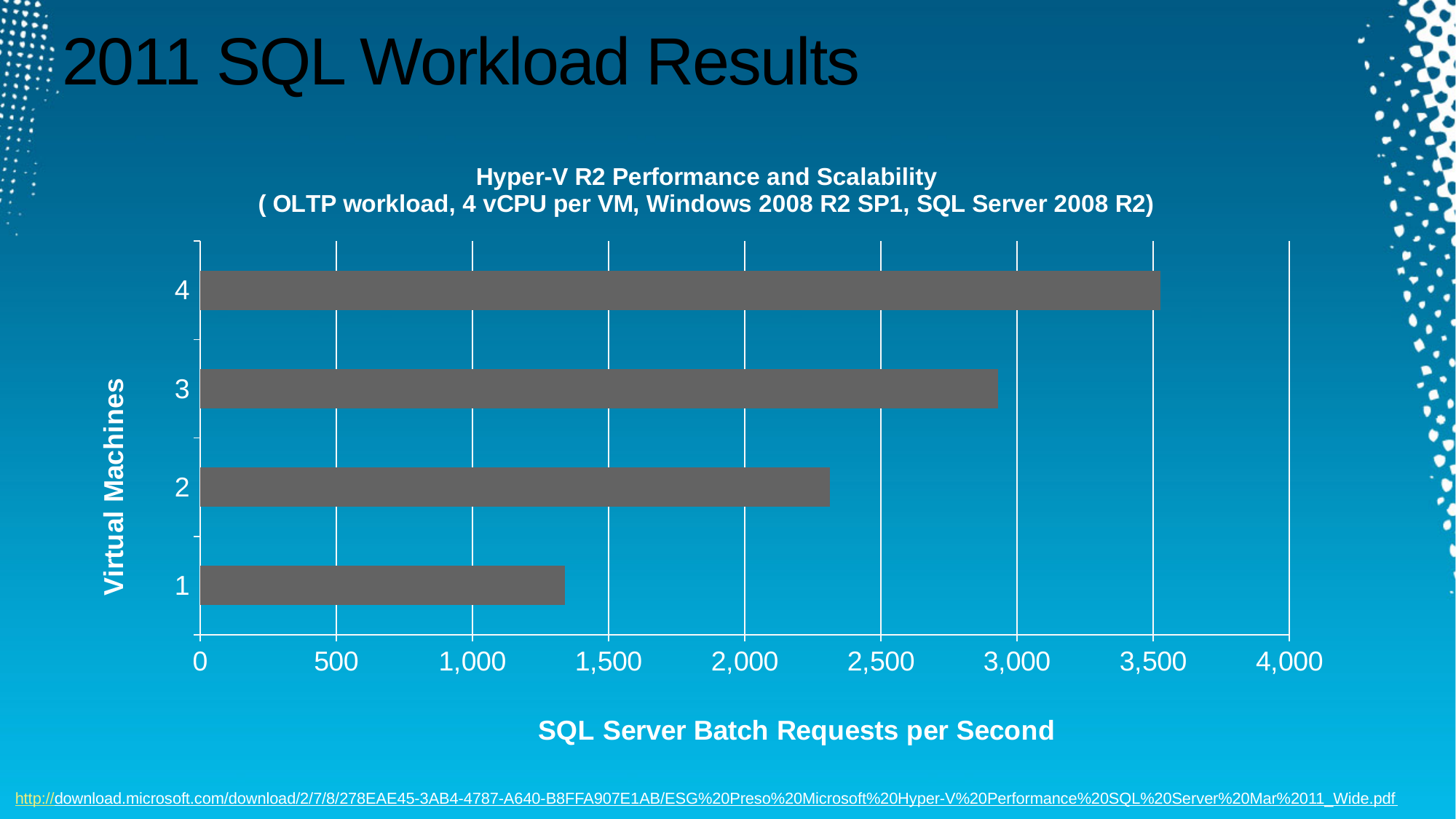
Which number of virtual machines has the highest SQL Server batch requests per second? 4 What kind of chart is shown on the slide? bar chart Is the value for 3 virtual machines greater or less than 3,000? less Is the value for 2 virtual machines greater or less than 2,000? greater Is the value for 1 virtual machine greater or less than 1,500? less How many virtual machine categories are plotted in the chart? 4 Which number of virtual machines has the lowest SQL Server batch requests per second? 1 Which has more SQL Server batch requests per second, 2 virtual machines or 3 virtual machines? 3 virtual machines What is the label of the vertical axis of the chart? Virtual Machines Do the SQL Server batch requests per second rise or fall as the number of virtual machines increases from 1 to 4? rise What is the label of the horizontal axis of the chart? SQL Server Batch Requests per Second